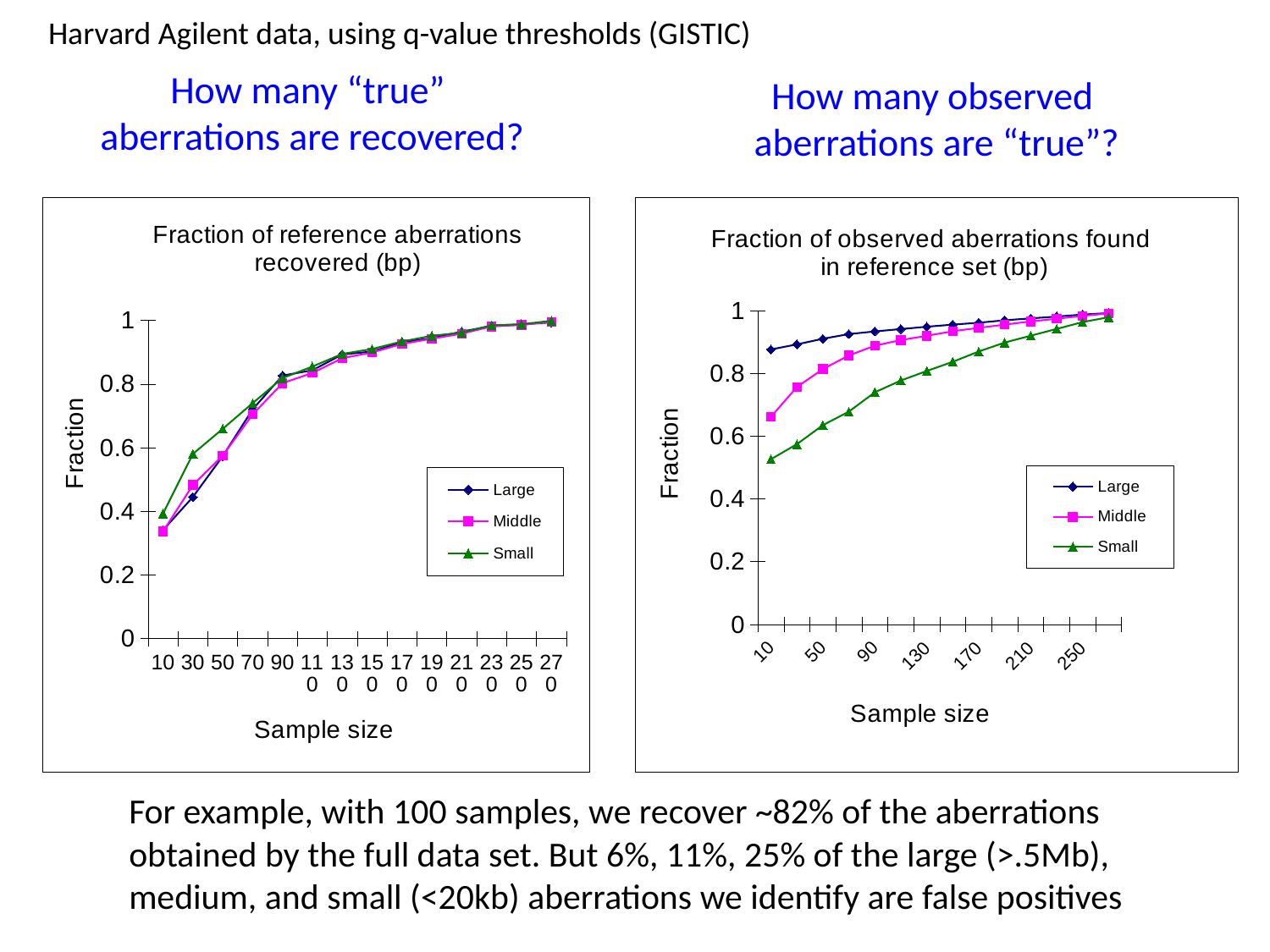
In the right chart, 'Fraction of observed aberrations found in reference set (bp)', which series has the highest value at sample size 10? Large How many sample sizes are labeled on the x axis of the left chart, 'Fraction of reference aberrations recovered (bp)'? 14 In the right chart, 'Fraction of observed aberrations found in reference set (bp)', is the value for Small at sample size 10 greater or less than 0.6? less What are the legend entries of the left chart, 'Fraction of reference aberrations recovered (bp)'? Large, Middle, Small In the right chart, 'Fraction of observed aberrations found in reference set (bp)', which is larger at sample size 50: Middle or Small? Middle What kind of chart is the left chart, 'Fraction of reference aberrations recovered (bp)'? line chart In the right chart, 'Fraction of observed aberrations found in reference set (bp)', which series has the lowest value at sample size 10? Small In the right chart, 'Fraction of observed aberrations found in reference set (bp)', is the value for Large at sample size 10 greater or less than 0.8? greater In the right chart, 'Fraction of observed aberrations found in reference set (bp)', do the values rise or fall as sample size increases? rise In the left chart, 'Fraction of reference aberrations recovered (bp)', is the value for Middle at sample size 10 greater or less than 0.4? less How many series does the legend of the right chart, 'Fraction of observed aberrations found in reference set (bp)', list? 3